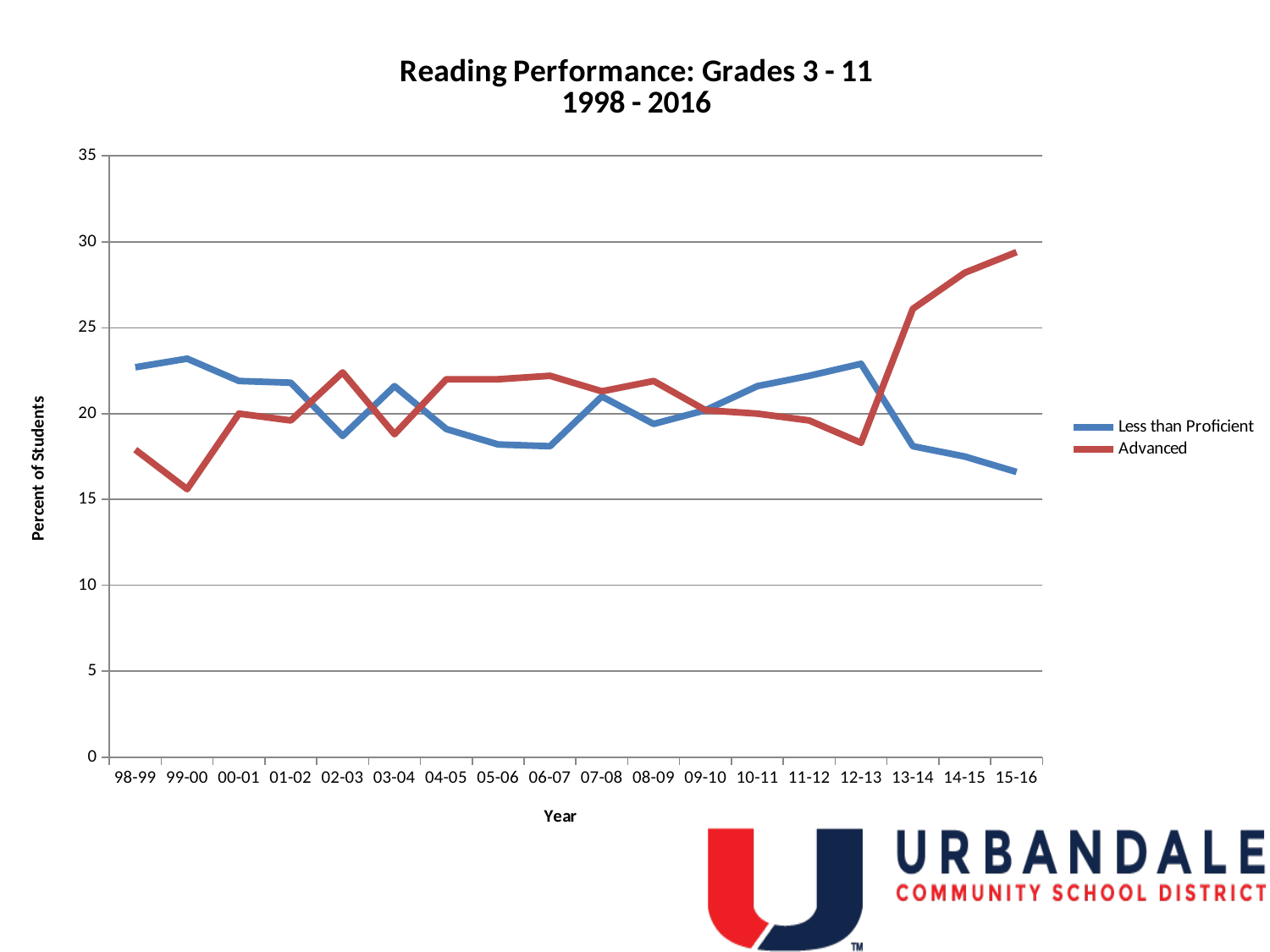
Is the Less than Proficient value for 15-16 greater or less than 20? less Is the Advanced value for 99-00 greater or less than 20? less How many school years are plotted along the x axis? 18 In 98-99, which series has the higher value, Less than Proficient or Advanced? Less than Proficient What kind of chart is shown on the slide? Line chart In which year is the Less than Proficient series at its lowest? 15-16 How many series does the legend list? 2 In 15-16, which series has the higher value, Less than Proficient or Advanced? Advanced In which year is the Advanced series at its lowest? 99-00 In which year is the Advanced series at its highest? 15-16 Is the Advanced value for 15-16 greater or less than 25? greater Does the Advanced series rise or fall from 12-13 to 15-16? Rise